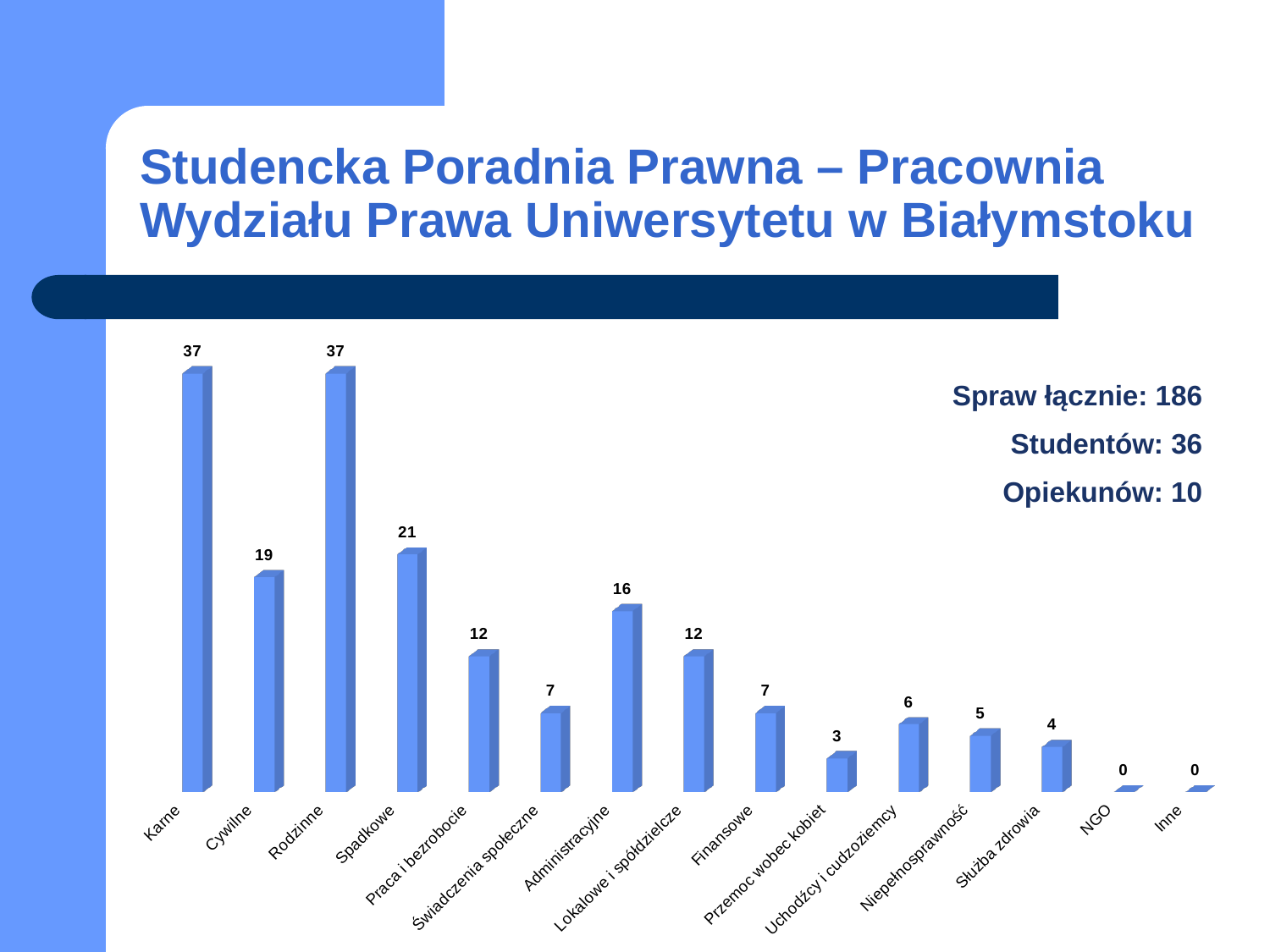
What is the value for Przemoc wobec kobiet? 3 How many categories are shown in the chart? 15 What kind of chart is shown on the slide? Bar chart What is the value for Karne? 37 What is the value for Niepełnosprawność? 5 What is the difference between the values for Rodzinne and Cywilne? 18 Which is larger, the value for Uchodźcy i cudzoziemcy or the value for Służba zdrowia? Uchodźcy i cudzoziemcy What is the value for Spadkowe? 21 What is the highest value shown in the chart? 37 What is the difference between the values for Administracyjne and Finansowe? 9 Which is larger, the value for Cywilne or the value for Spadkowe? Spadkowe What is the value for Administracyjne? 16